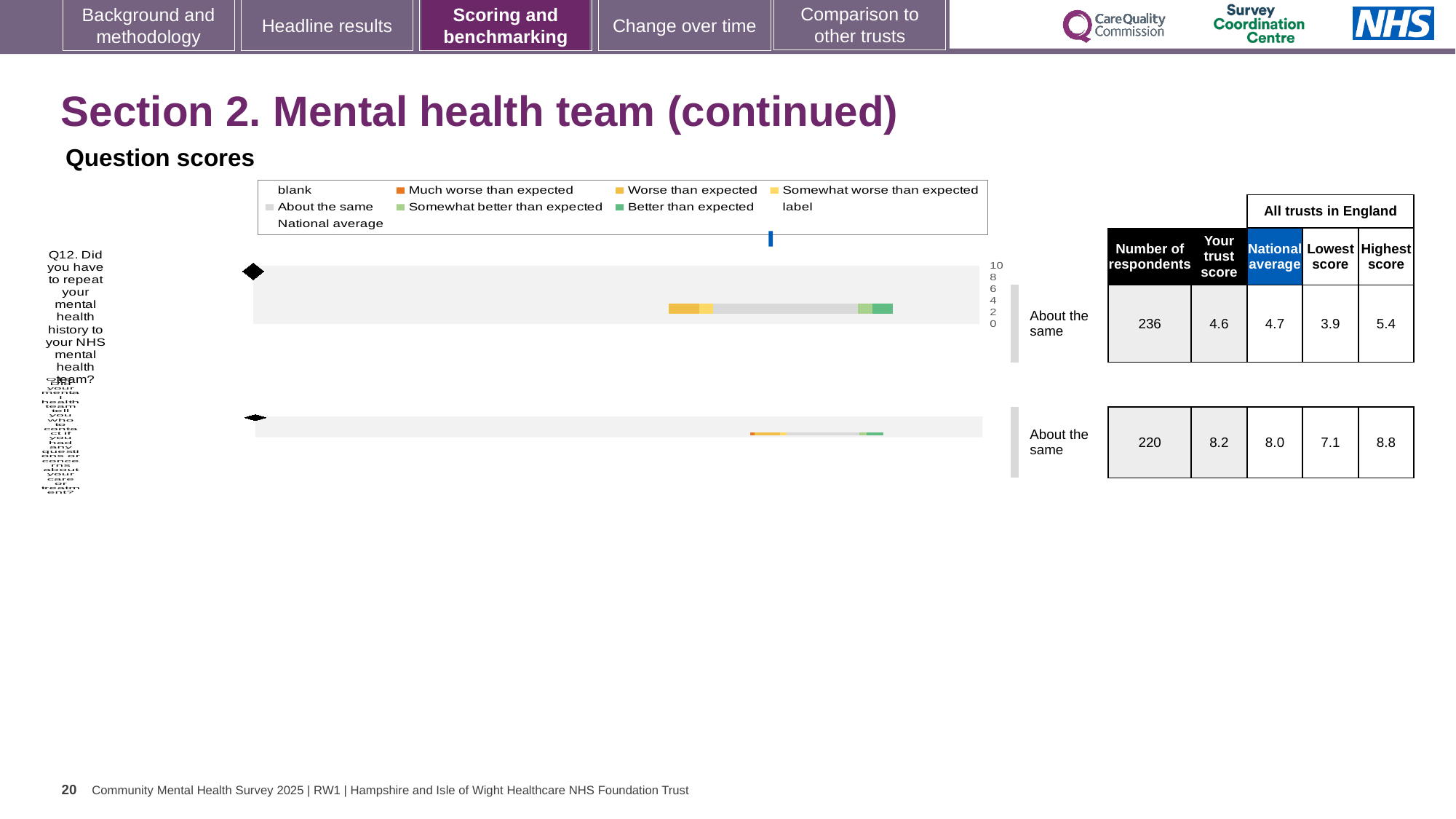
What is the difference between the national average and the trust's score for Q12? 0.1 What benchmark category is shown for Q12? About the same What is the national average score for Q12? 4.7 What is the heading above the Lowest score and Highest score columns in the table? All trusts in England What is the highest score among all trusts in England for Q12? 5.4 What is the lowest score among all trusts in England for Q12? 3.9 How many entries does the chart legend list? 9 For Q12, which is larger: the trust's score or the national average? National average What is the difference between the highest and lowest trust scores in England for Q12? 1.5 What is the number of respondents for Q12 (repeating mental health history to the NHS mental health team)? 236 What is the trust's score for Q12? 4.6 What kind of chart is shown on the slide? bar chart